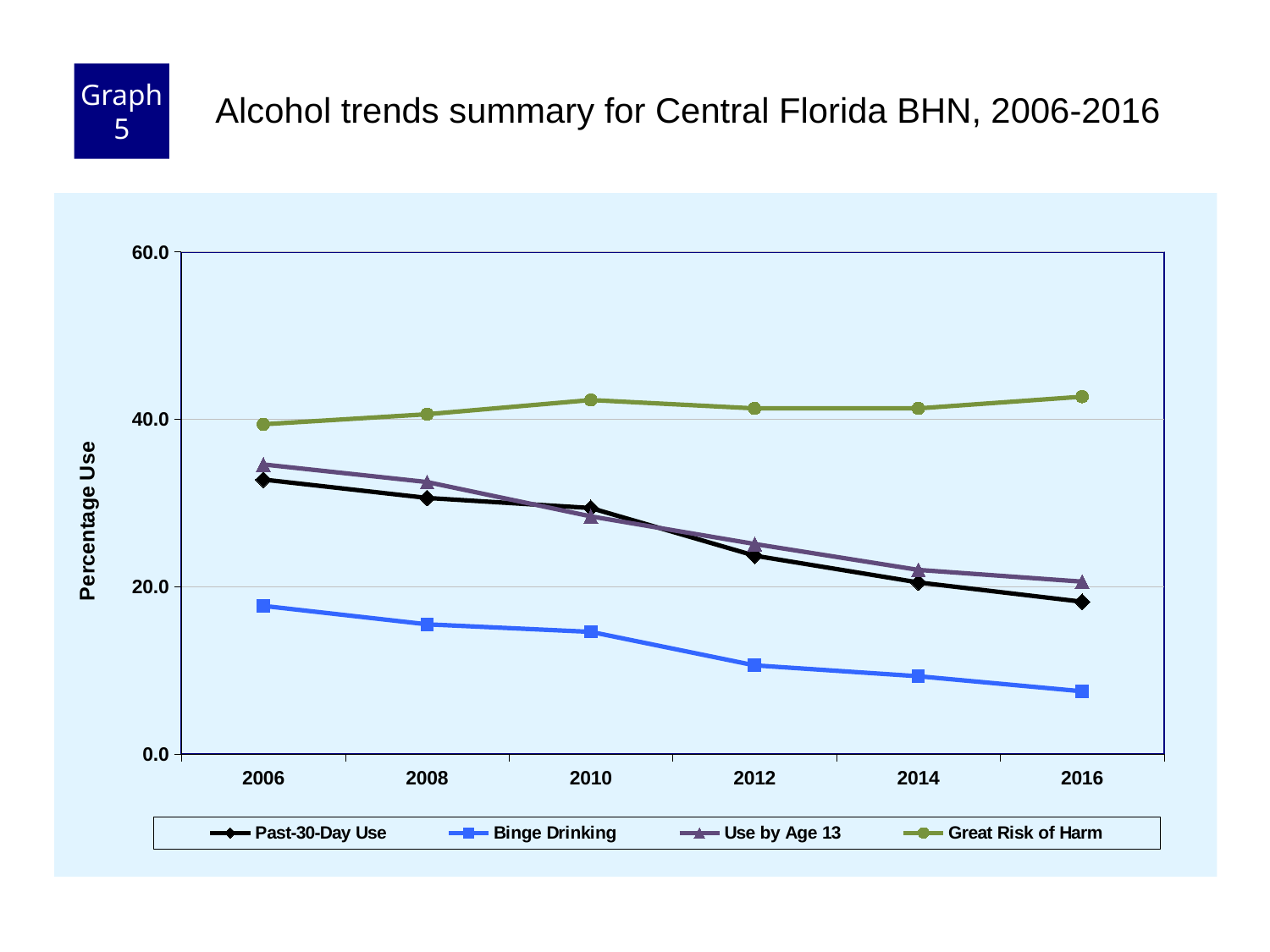
Which series has the lowest value in 2016? Binge Drinking Is the value for Great Risk of Harm in 2016 greater or less than 40.0? greater Is the value for Past-30-Day Use in 2006 greater or less than 20.0? greater Which series has the highest value in 2016? Great Risk of Harm Does the Binge Drinking line rise or fall from 2006 to 2016? Fall How many series does the legend list? 4 Is the value for Binge Drinking in 2016 greater or less than 20.0? less In 2012, which is larger: Great Risk of Harm or Binge Drinking? Great Risk of Harm What kind of chart is shown on the slide? Line chart Does the Past-30-Day Use line rise or fall from 2006 to 2016? Fall How many years are plotted along the x axis? 6 What is the label on the y axis of the chart? Percentage Use